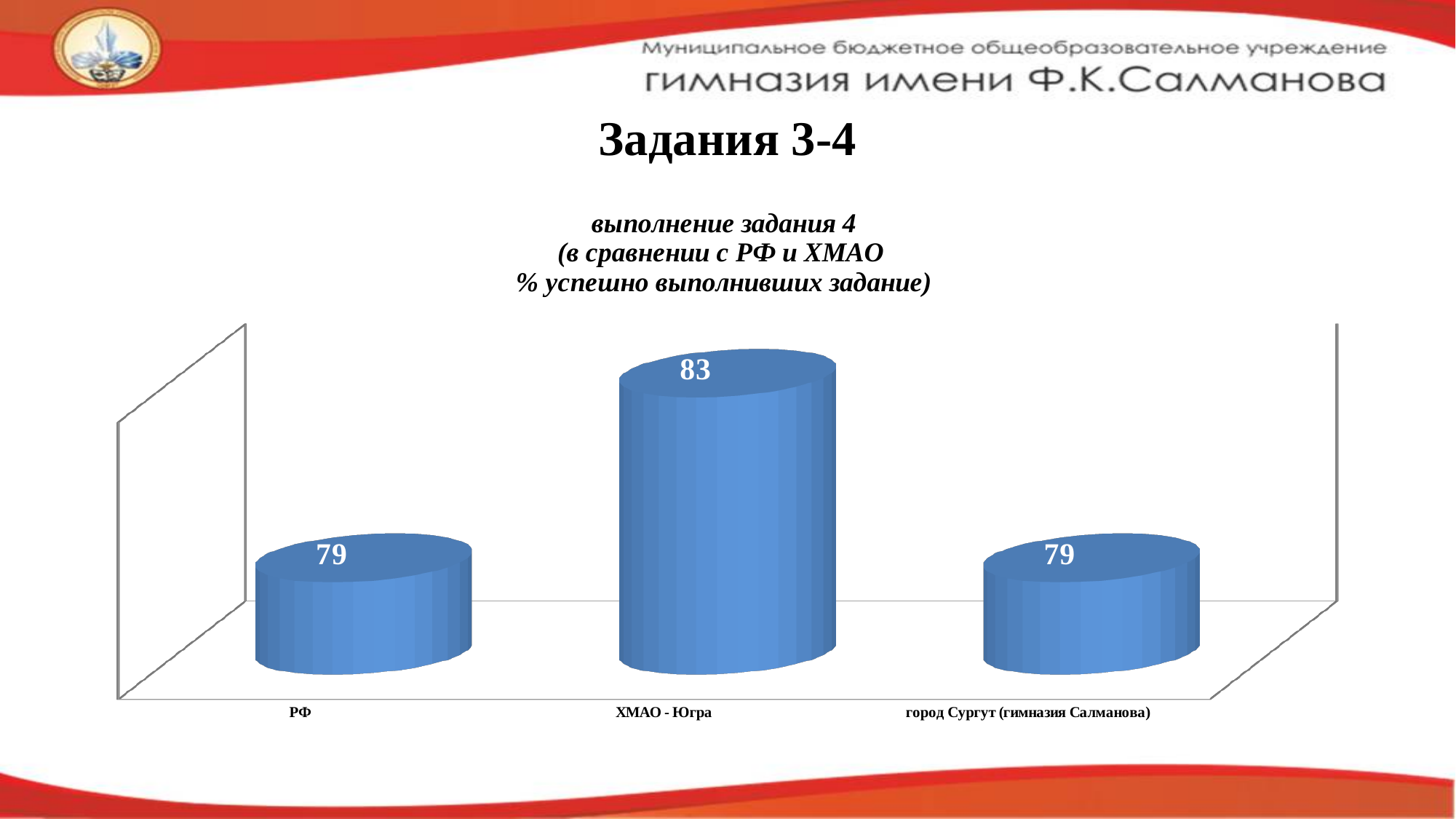
What is the difference between the values for ХМАО - Югра and РФ? 4 What colour are the bars in the chart? blue What is the value for город Сургут (гимназия Салманова)? 79 Which is larger, the value for ХМАО - Югра or the value for город Сургут (гимназия Салманова)? ХМАО - Югра What is the title of the chart? выполнение задания 4 (в сравнении с РФ и ХМАО % успешно выполнивших задание) How many categories are shown in the chart? 3 Which category has the highest value? ХМАО - Югра Are the values for РФ and город Сургут (гимназия Салманова) equal? Yes What is the value for РФ? 79 What is the value for ХМАО - Югра? 83 What kind of chart is shown on the slide? bar chart